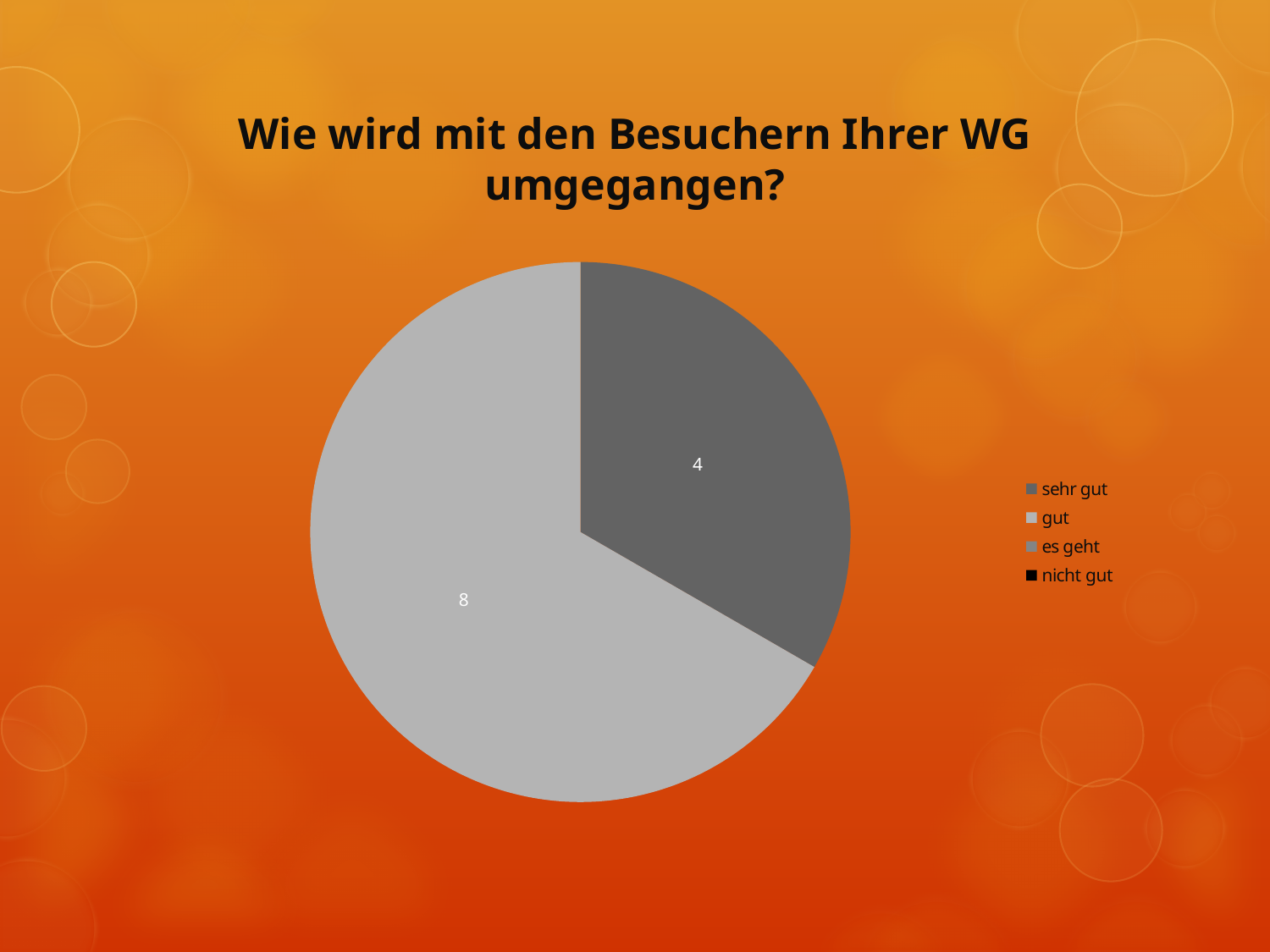
What kind of chart is shown on the slide? pie chart How many entries does the legend of the pie chart list? 4 What value is shown for the 'gut' slice of the pie chart? 8 What is the difference between the values for 'gut' and 'sehr gut'? 4 Which category has the largest slice in the pie chart? gut Which is larger, the value for 'sehr gut' or the value for 'gut'? gut What is the sum of the two labelled values in the pie chart? 12 What value is shown for the 'sehr gut' slice of the pie chart? 4 What is the title of the slide containing the pie chart? Wie wird mit den Besuchern Ihrer WG umgegangen? How many slices with data labels are visible in the pie chart? 2 What fraction of the pie does the 'gut' slice represent? 2/3 Which legend entry is shown with the darkest (black) colour? nicht gut